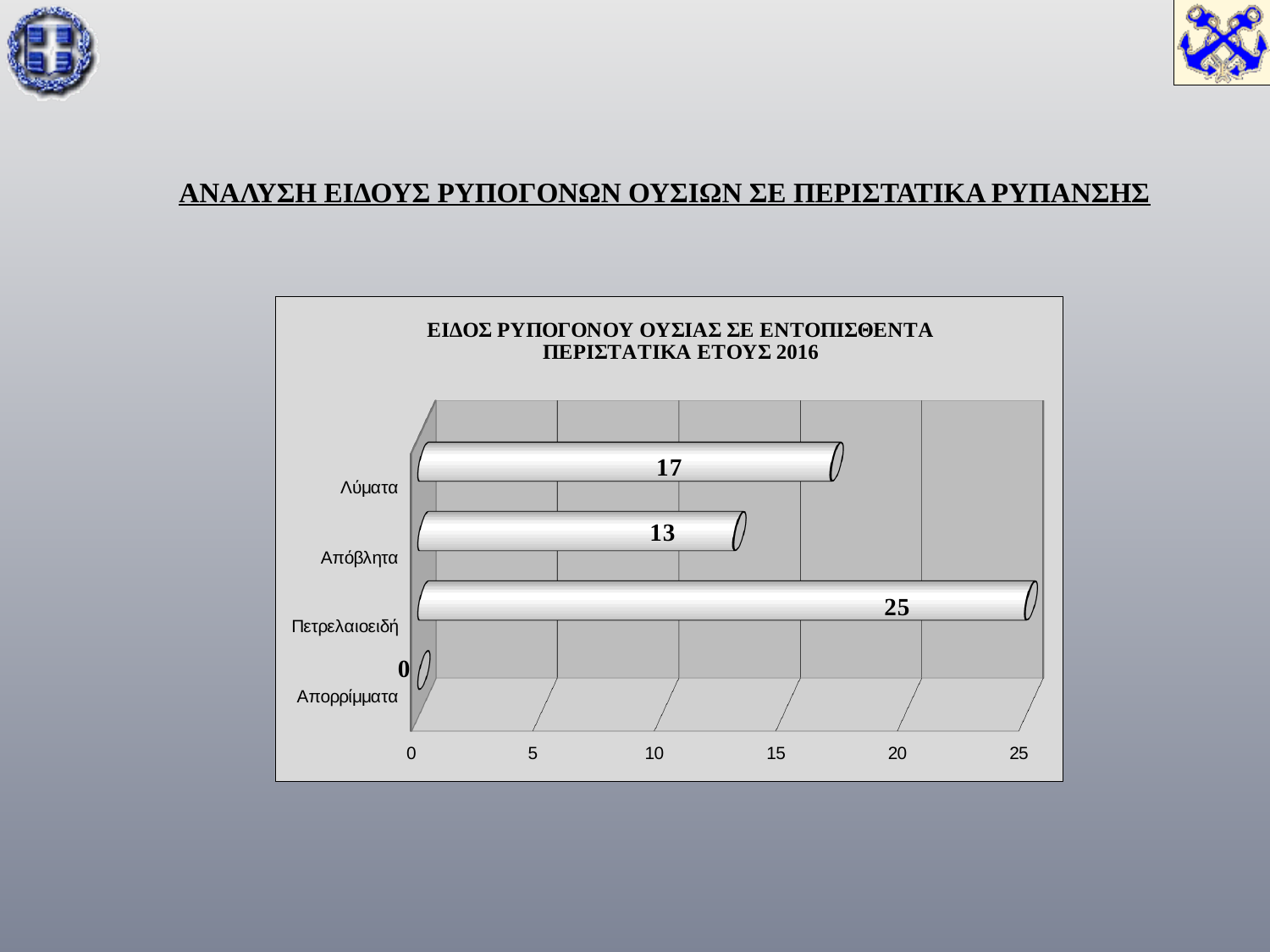
What is the value for Απορρίμματα? 0 What is the title of the chart? ΕΙΔΟΣ ΡΥΠΟΓΟΝΟΥ ΟΥΣΙΑΣ ΣΕ ΕΝΤΟΠΙΣΘΕΝΤΑ ΠΕΡΙΣΤΑΤΙΚΑ ΕΤΟΥΣ 2016 What is the value for Απόβλητα? 13 What is the value for Πετρελαιοειδή? 25 How many categories are shown in the chart? 4 Which category has the highest value? Πετρελαιοειδή What kind of chart is shown on the slide? Bar chart Which category has the lowest value? Απορρίμματα What is the value for Λύματα? 17 What is the difference between the values for Πετρελαιοειδή and Λύματα? 8 Which is larger, the value for Λύματα or the value for Απόβλητα? Λύματα What is the difference between the values for Λύματα and Απόβλητα? 4